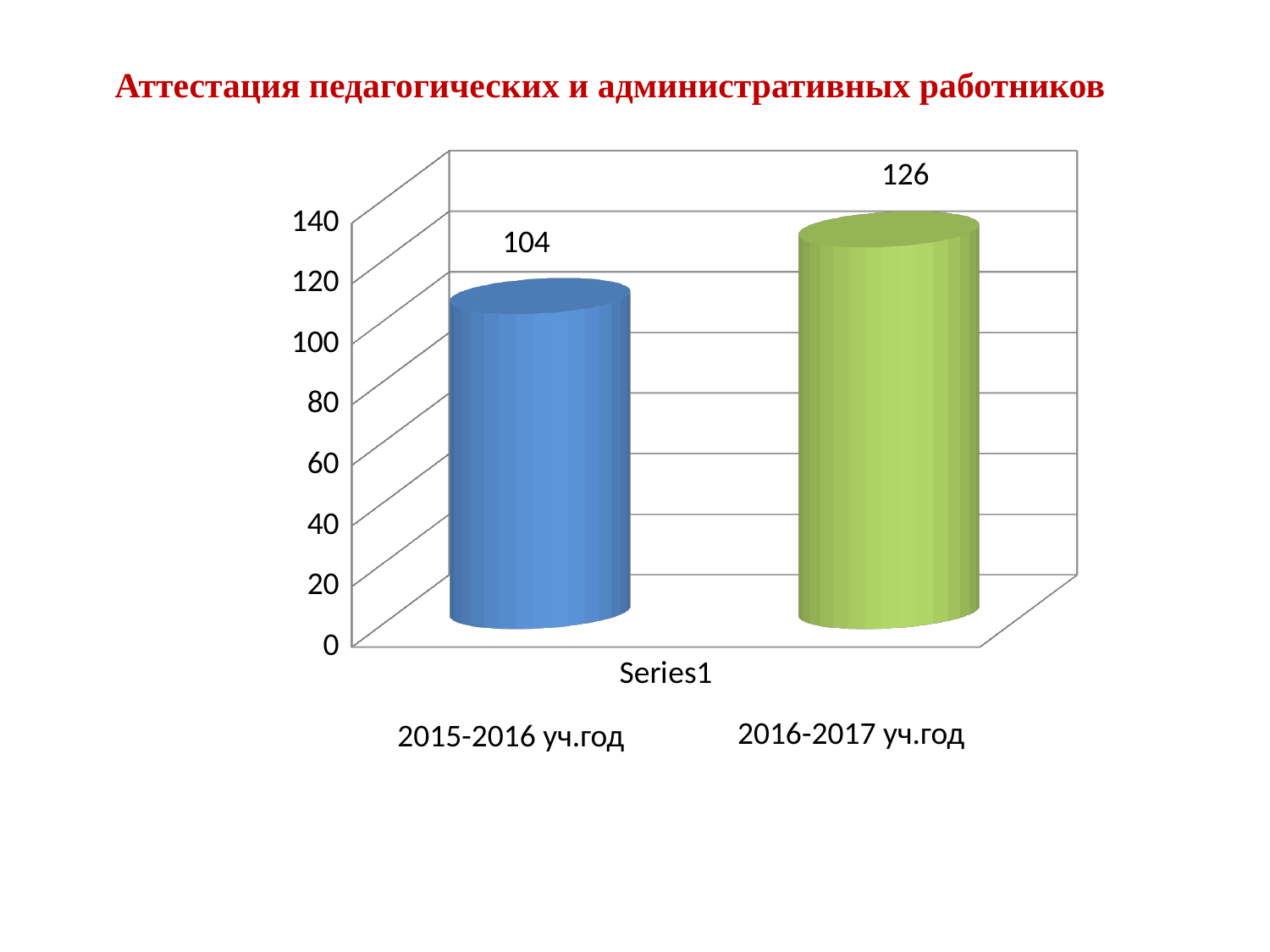
What is the value for 2016-2017 уч.год? 126 What is the title of the slide? Аттестация педагогических и административных работников Is the value for 2016-2017 уч.год larger or smaller than the value for 2015-2016 уч.год? larger Is the value for 2016-2017 уч.год greater or less than 140? less Is the value for 2015-2016 уч.год greater or less than 100? greater What is the difference between the values for 2016-2017 уч.год and 2015-2016 уч.год? 22 How many bars are shown in the chart? 2 Which academic year has the higher value? 2016-2017 уч.год Which academic year has the lower value? 2015-2016 уч.год Do the values rise or fall from 2015-2016 уч.год to 2016-2017 уч.год? rise What is the value for 2015-2016 уч.год? 104 What kind of chart is shown on the slide? bar chart